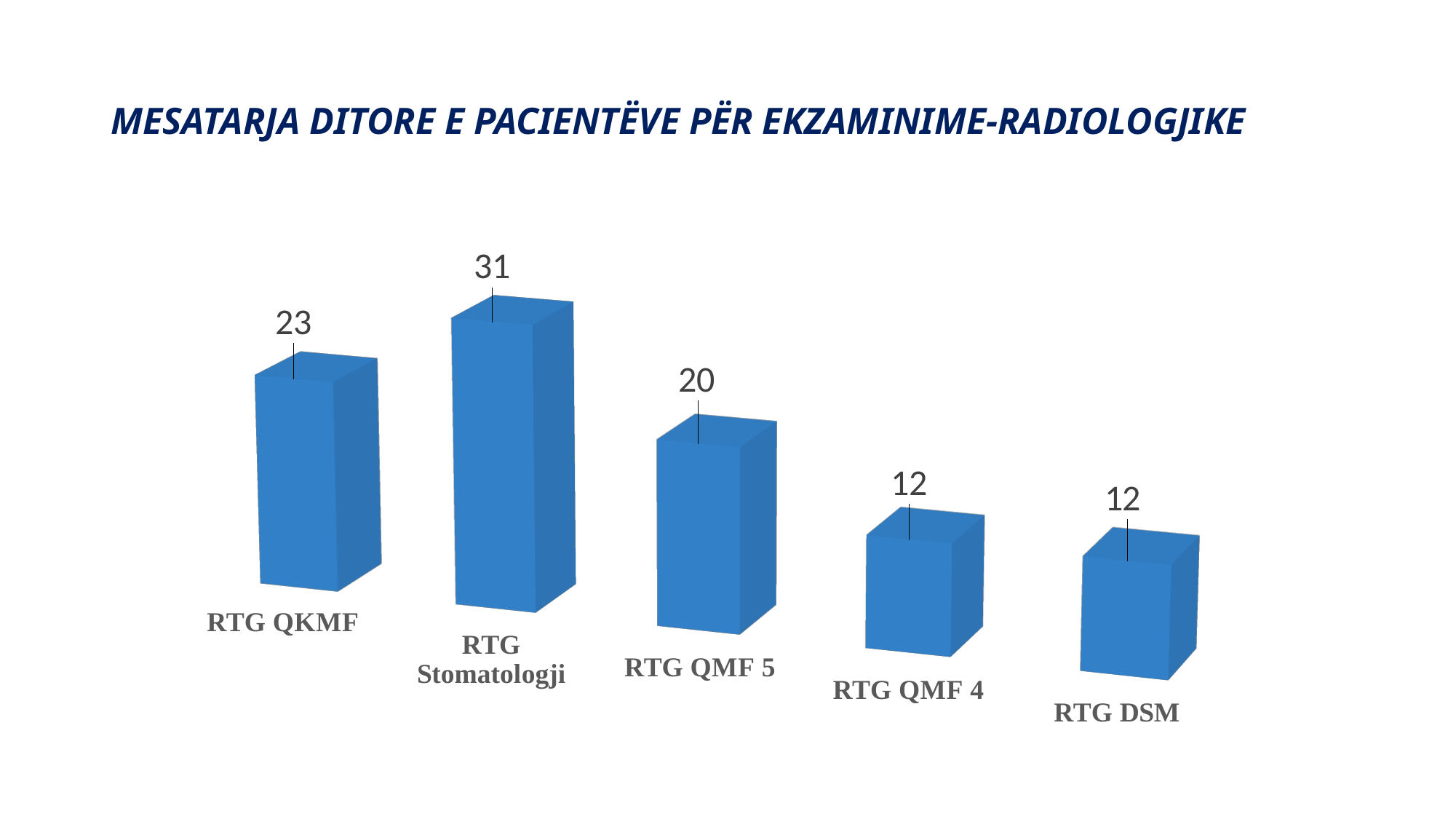
Which is larger, the value for RTG QKMF or the value for RTG QMF 5? RTG QKMF What kind of chart is shown on the slide? Bar chart How many categories are shown in the chart? 5 What is the difference between the values for RTG Stomatologji and RTG QKMF? 8 What is the value for RTG Stomatologji? 31 What is the value for RTG QMF 5? 20 What is the value for RTG QKMF? 23 What is the value for RTG DSM? 12 Which category has the highest value? RTG Stomatologji What is the title of the chart? MESATARJA DITORE E PACIENTËVE PËR EKZAMINIME-RADIOLOGJIKE Do the values for RTG QMF 4 and RTG DSM differ? No, both are 12 What is the difference between the values for RTG QMF 5 and RTG QMF 4? 8